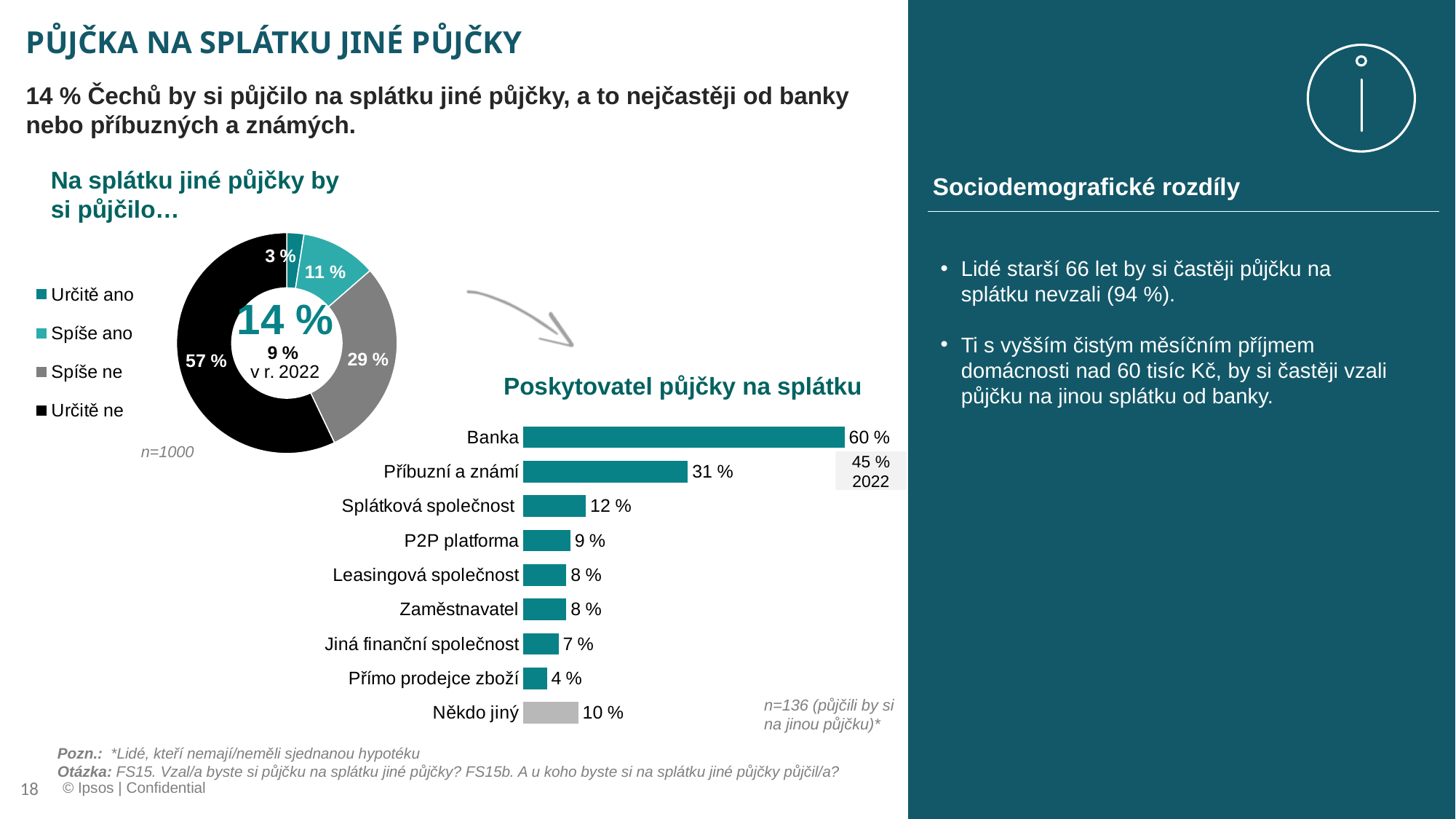
In the 'Poskytovatel půjčky na splátku' chart, which category has the lowest value? Přímo prodejce zboží In the 'Poskytovatel půjčky na splátku' chart, what is the difference between the values for Banka and Příbuzní a známí? 29 % In the donut chart 'Na splátku jiné půjčky by si půjčilo…', which category has the smallest share? Určitě ano In the 'Poskytovatel půjčky na splátku' chart, what is the value for Příbuzní a známí? 31 % How many entries does the legend of the donut chart 'Na splátku jiné půjčky by si půjčilo…' list? 4 In the donut chart 'Na splátku jiné půjčky by si půjčilo…', what is the share for Určitě ne? 57 % In the 'Poskytovatel půjčky na splátku' chart, which category has the highest value? Banka In the donut chart 'Na splátku jiné půjčky by si půjčilo…', what is the share for Spíše ano? 11 % What kind of chart is 'Poskytovatel půjčky na splátku'? Bar chart In the 'Poskytovatel půjčky na splátku' chart, what is the value for Banka? 60 % How many categories are shown in the 'Poskytovatel půjčky na splátku' chart? 9 In the 'Poskytovatel půjčky na splátku' chart, which is larger: Splátková společnost or Někdo jiný? Splátková společnost